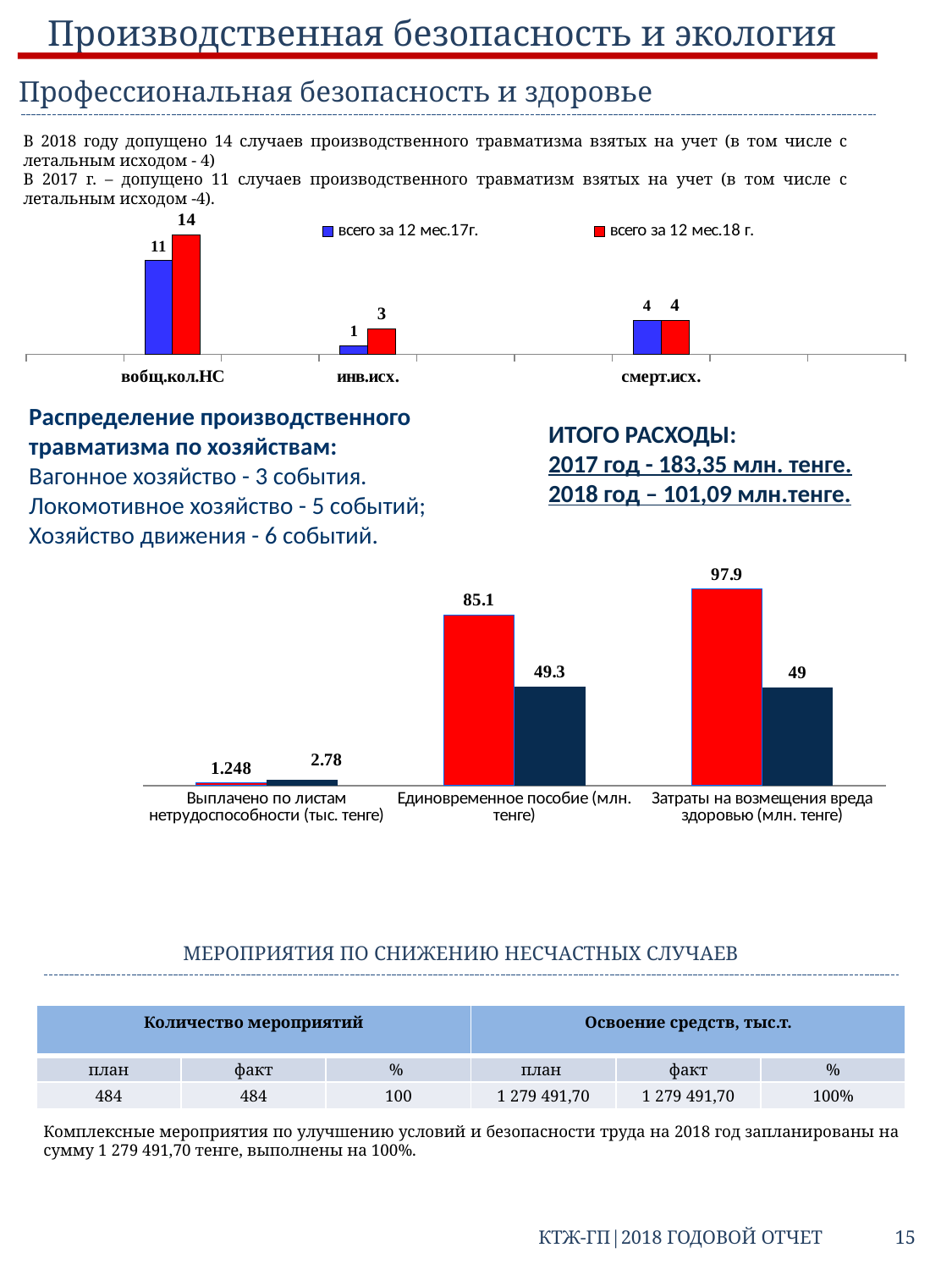
In the top chart (injury cases), what is the value for 'инв.исх.' in the series 'всего за 12 мес.17г.'? 1 In the top chart (injury cases), what is the value for 'вобщ.кол.НС' in the series 'всего за 12 мес.18 г.'? 14 In the top chart (injury cases), which colour represents the series 'всего за 12 мес.17г.'? Blue In the bottom chart (expenses), what is the value of the red bar for 'Затраты на возмещения вреда здоровью (млн. тенге)'? 97.9 In the bottom chart (expenses), what is the difference between the red and dark blue bars for 'Единовременное пособие (млн. тенге)'? 35.8 In the top chart (injury cases), how many series does the legend list? 2 In the top chart (injury cases), what is the difference between the 2018 and 2017 values for 'вобщ.кол.НС'? 3 In the top chart (injury cases), how many categories are shown on the x axis? 3 In the bottom chart (expenses), which is larger for 'Выплачено по листам нетрудоспособности (тыс. тенге)': the red bar or the dark blue bar? The dark blue bar In the bottom chart (expenses), what is the value of the dark blue bar for 'Единовременное пособие (млн. тенге)'? 49.3 What type of chart is the bottom chart (expenses)? Bar chart In the top chart (injury cases), which category has the highest value in the series 'всего за 12 мес.18 г.'? вобщ.кол.НС